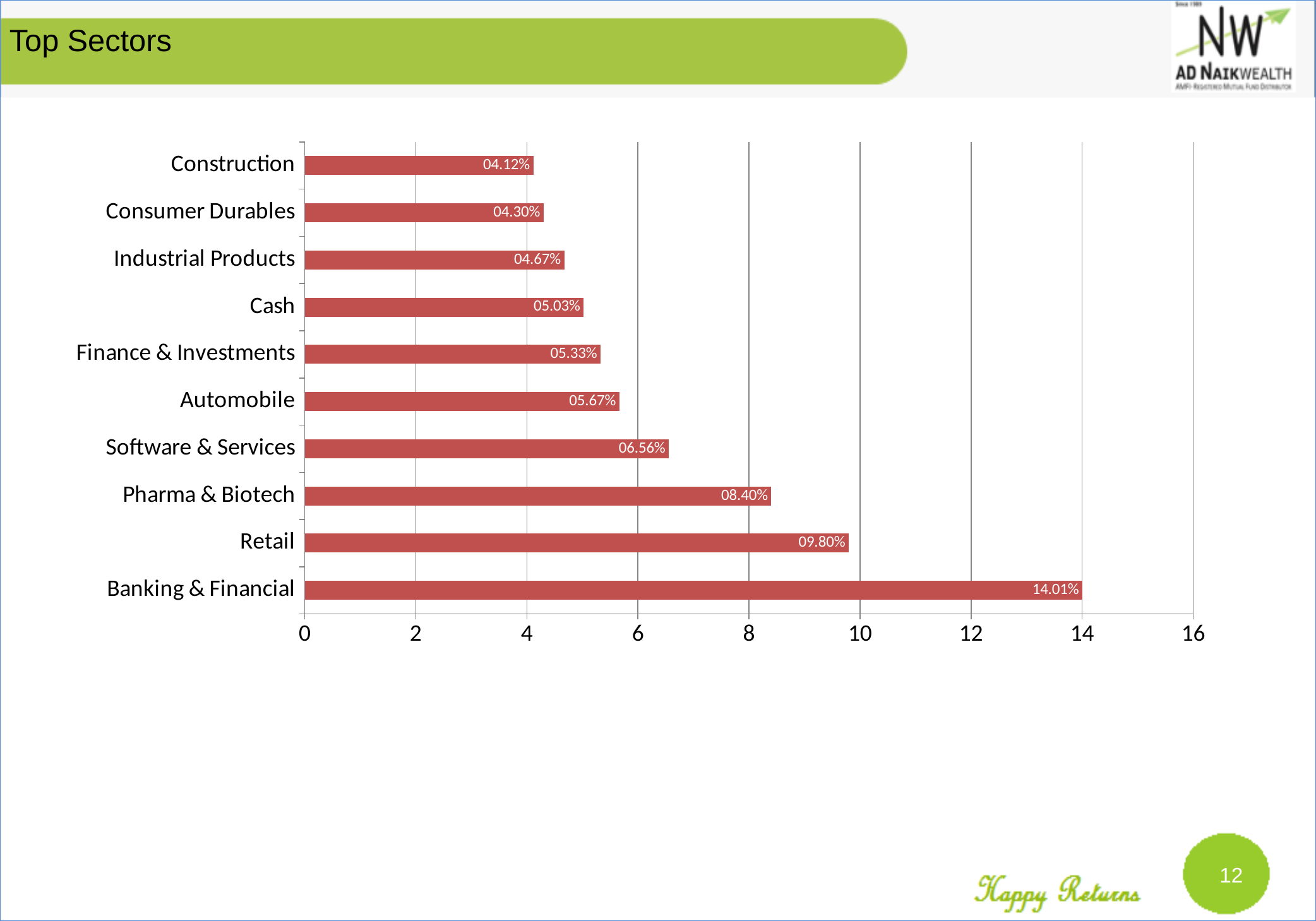
What is the value for Pharma & Biotech? 08.40% How many sectors are shown in the chart? 10 What is the difference between the values for Banking & Financial and Retail? 4.21% What is the title of the slide containing the chart? Top Sectors Which sector has the highest value? Banking & Financial Which sector has the lowest value? Construction What is the value for Cash? 05.03% What kind of chart is shown on the slide? bar chart What is the value for Banking & Financial? 14.01% What is the difference between the values for Software & Services and Automobile? 0.89% Is the value for Software & Services greater or less than 6? greater Which is larger, the value for Retail or the value for Pharma & Biotech? Retail